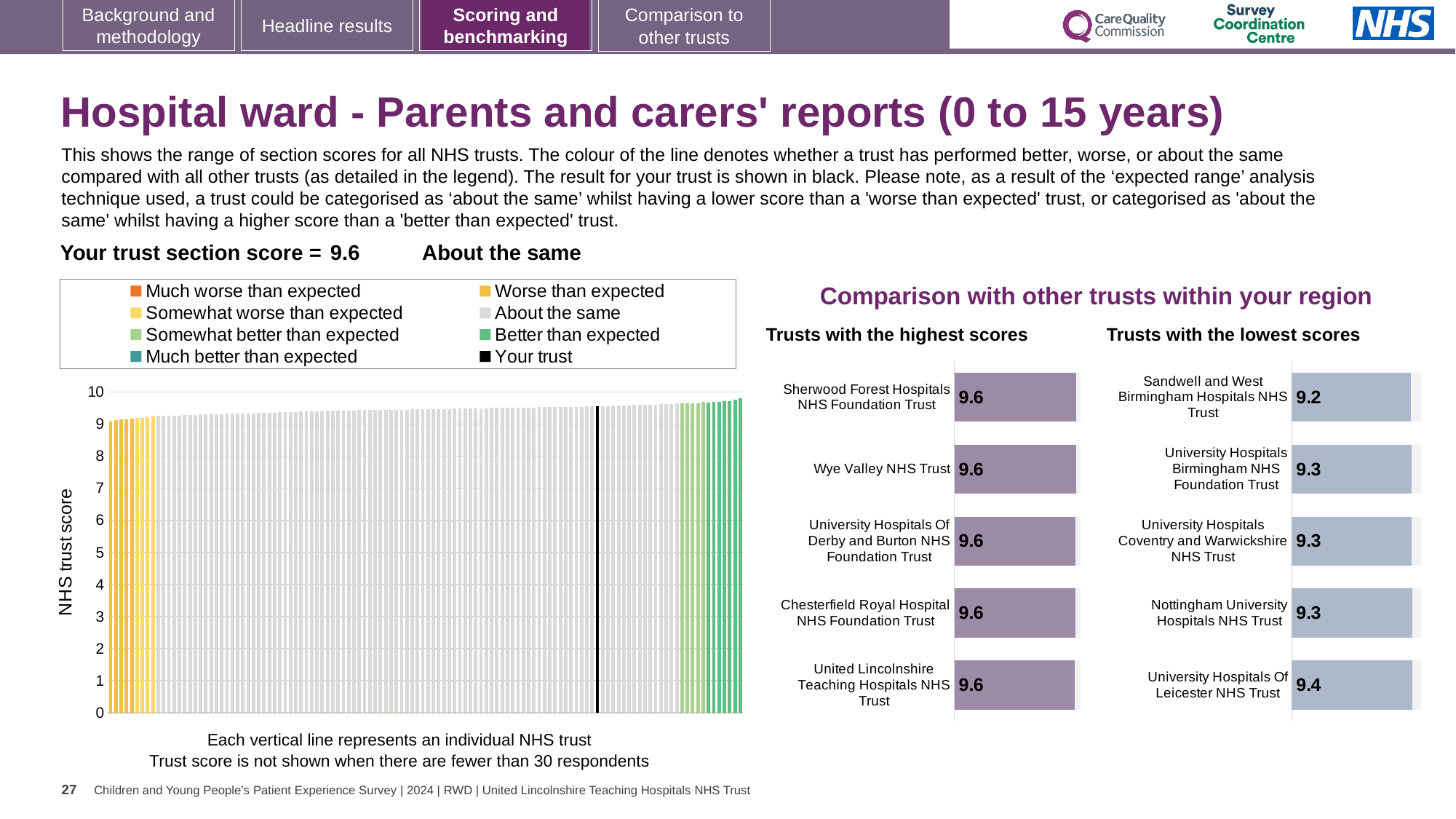
In the 'Trusts with the lowest scores' chart, which has the larger score: Nottingham University Hospitals NHS Trust or Sandwell and West Birmingham Hospitals NHS Trust? Nottingham University Hospitals NHS Trust In the 'Trusts with the lowest scores' chart, what is the difference between the scores of University Hospitals Of Leicester NHS Trust and Sandwell and West Birmingham Hospitals NHS Trust? 0.2 In the 'NHS trust score' chart on the left, is the value for your trust (the black line) greater or less than 9? greater How many entries does the legend above the 'NHS trust score' chart list? 8 What kind of chart is the 'NHS trust score' chart on the left of the slide? Bar chart In the 'Trusts with the lowest scores' chart, which trust has the highest score? University Hospitals Of Leicester NHS Trust In the 'Trusts with the lowest scores' chart, what is the score for Sandwell and West Birmingham Hospitals NHS Trust? 9.2 In the 'Trusts with the lowest scores' chart, what is the score for University Hospitals Of Leicester NHS Trust? 9.4 How many trusts are listed in the 'Trusts with the highest scores' chart? 5 In the 'Trusts with the lowest scores' chart, which trust has the lowest score? Sandwell and West Birmingham Hospitals NHS Trust In the 'Trusts with the highest scores' chart, what is the score for Wye Valley NHS Trust? 9.6 What is the label on the vertical axis of the chart on the left of the slide? NHS trust score